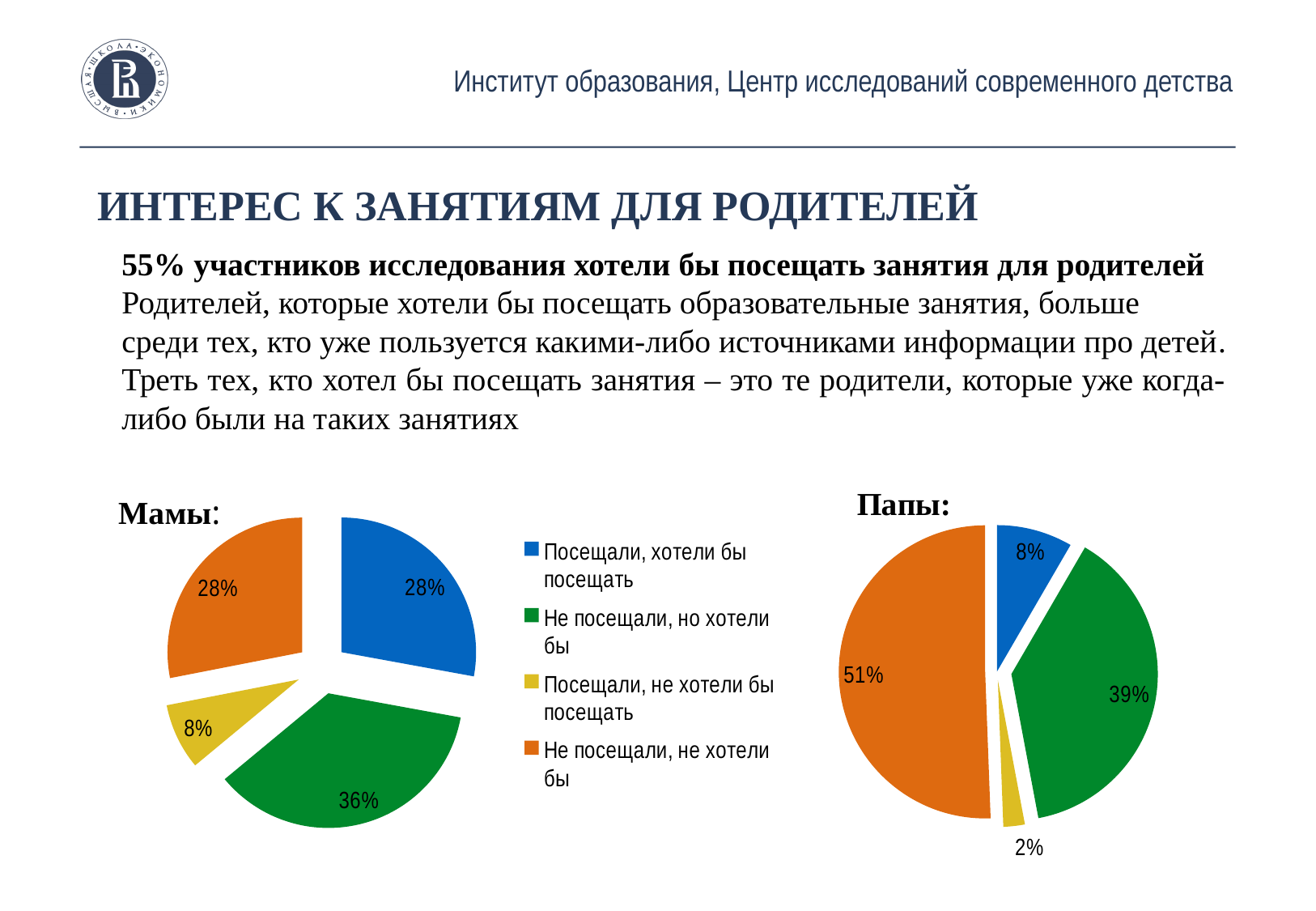
How many slices does the 'Мамы' pie chart have? 4 Which is larger: the 'Не посещали, но хотели бы' share in the 'Папы' chart or in the 'Мамы' chart? Папы How many entries does the legend between the two charts list? 4 What type of chart is used for 'Папы'? Pie chart In the 'Папы' pie chart, which category has the smallest slice? Посещали, не хотели бы посещать What is the difference between the 'Не посещали, не хотели бы' share in the 'Папы' chart and the same category in the 'Мамы' chart? 23% In the 'Папы' pie chart, what share is labelled for 'Не посещали, не хотели бы'? 51% In the 'Папы' pie chart, what share is labelled for 'Посещали, хотели бы посещать'? 8% In the 'Папы' pie chart, which category has the largest slice? Не посещали, не хотели бы In the 'Мамы' pie chart, what share is labelled for 'Посещали, не хотели бы посещать'? 8% In the 'Мамы' pie chart, which category has the largest slice? Не посещали, но хотели бы In the 'Мамы' pie chart, what share is labelled for 'Не посещали, но хотели бы'? 36%